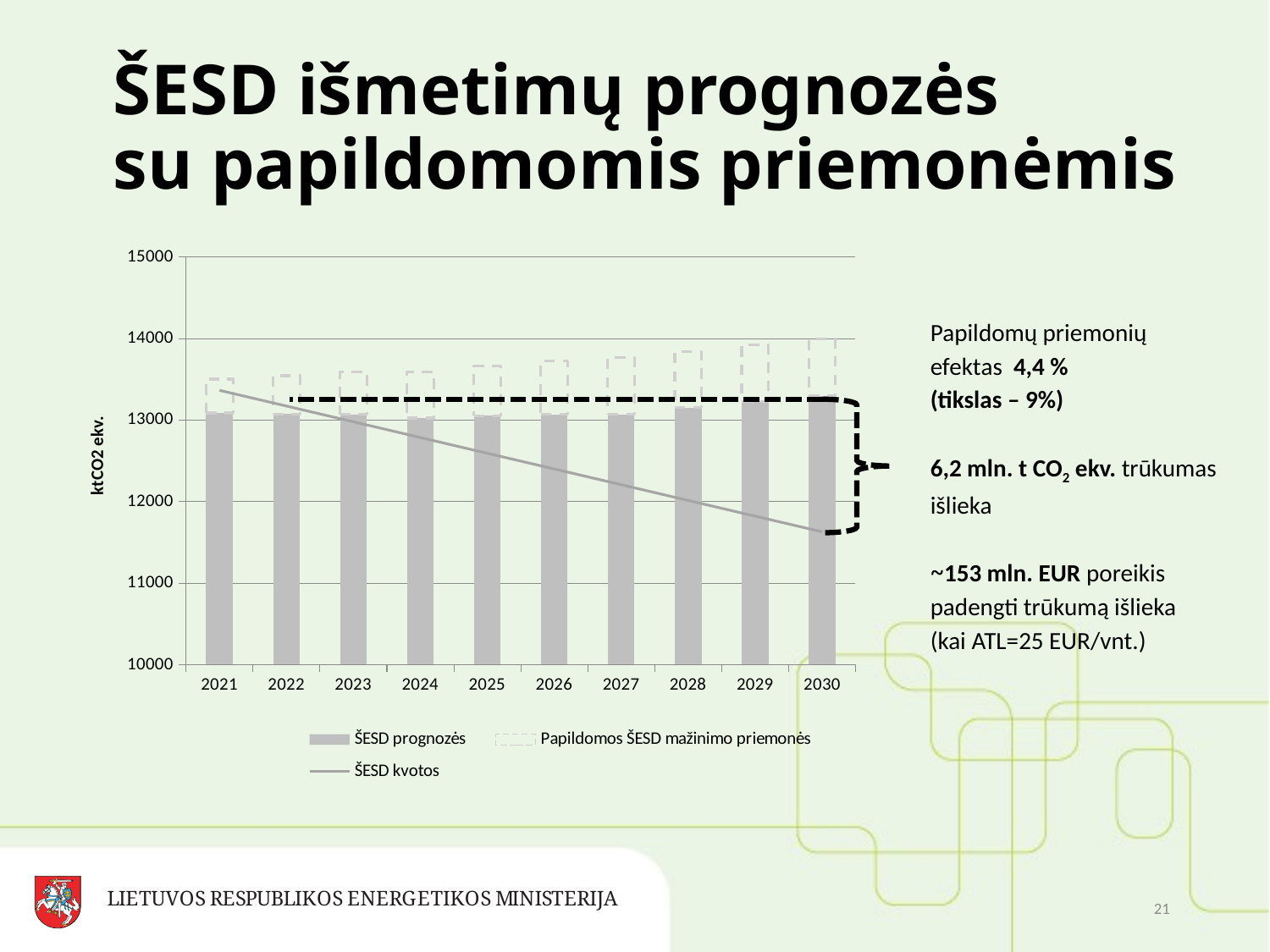
Is the ŠESD kvotos value for 2021 greater or less than 13000? greater What kind of chart is shown on the slide? combination bar and line chart Which series in the legend is drawn as a line? ŠESD kvotos How many years are shown on the x axis of the chart? 10 What is the label of the vertical axis of the chart? ktCO2 ekv. Is the ŠESD kvotos value for 2030 greater or less than 12000? less How many series does the chart legend list? 3 Which is larger in 2030, the ŠESD prognozės bar or the ŠESD kvotos line value? ŠESD prognozės bar Which is larger, the ŠESD prognozės bar for 2030 or for 2024? 2030 Is the ŠESD prognozės bar for 2021 greater or less than 13000? greater Does the ŠESD kvotos line rise or fall from 2021 to 2030? fall